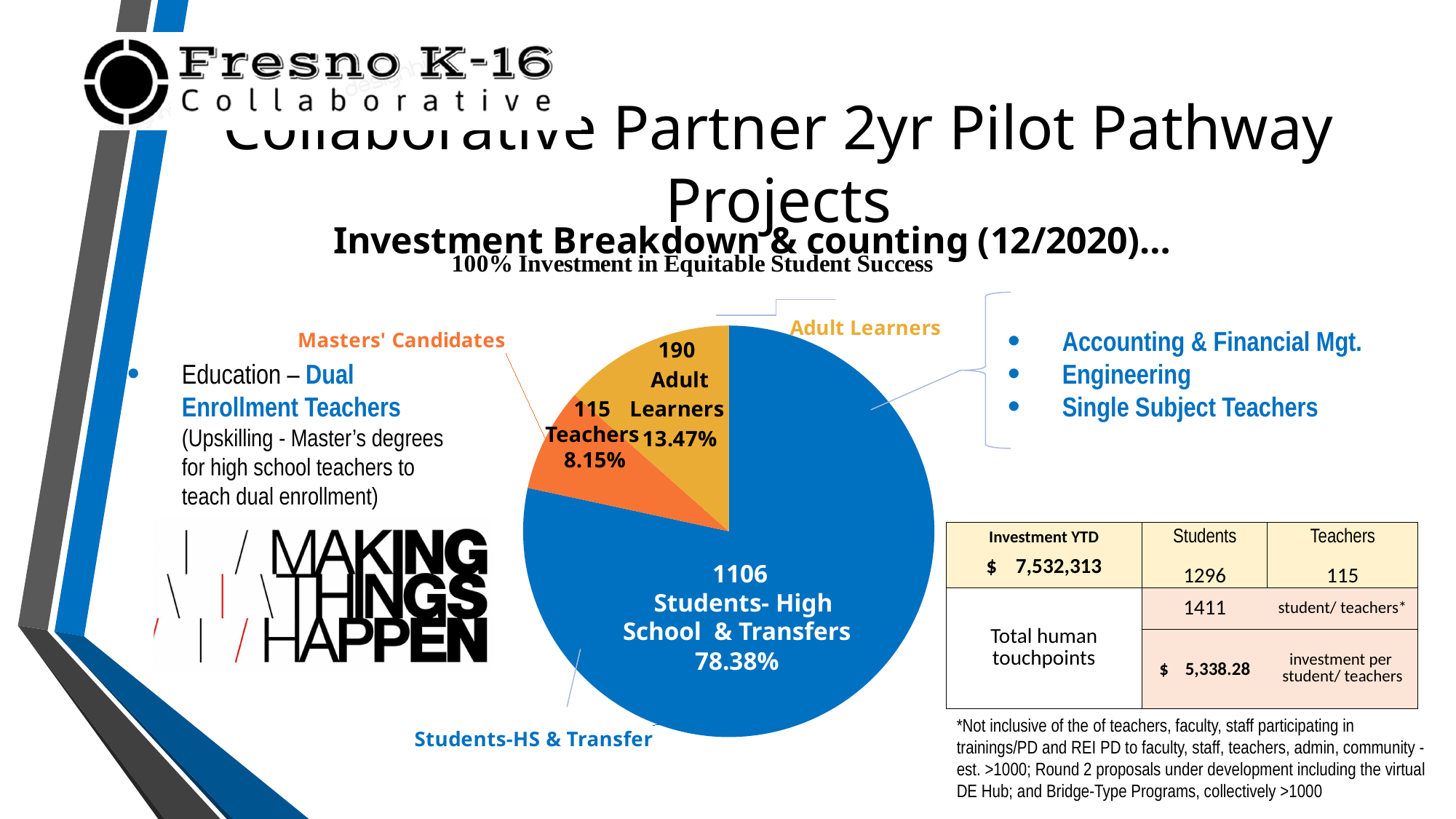
How many slices does the pie chart have? 3 What is the value shown for the Teachers slice of the pie chart? 115 What is the value shown for the Adult Learners slice of the pie chart? 190 Which slice of the pie chart is the largest? Students- High School & Transfers What is the difference between the Adult Learners value and the Teachers value in the pie chart? 75 What is the title of the pie chart? Investment Breakdown & counting (12/2020)… What percentage share of the pie chart do Adult Learners represent? 13.47% What percentage share of the pie chart do Students- High School & Transfers represent? 78.38% What is the value shown for the Students- High School & Transfers slice of the pie chart? 1106 What percentage share of the pie chart do Teachers represent? 8.15% What kind of chart is shown on the slide? pie chart Which slice of the pie chart is the smallest? Teachers